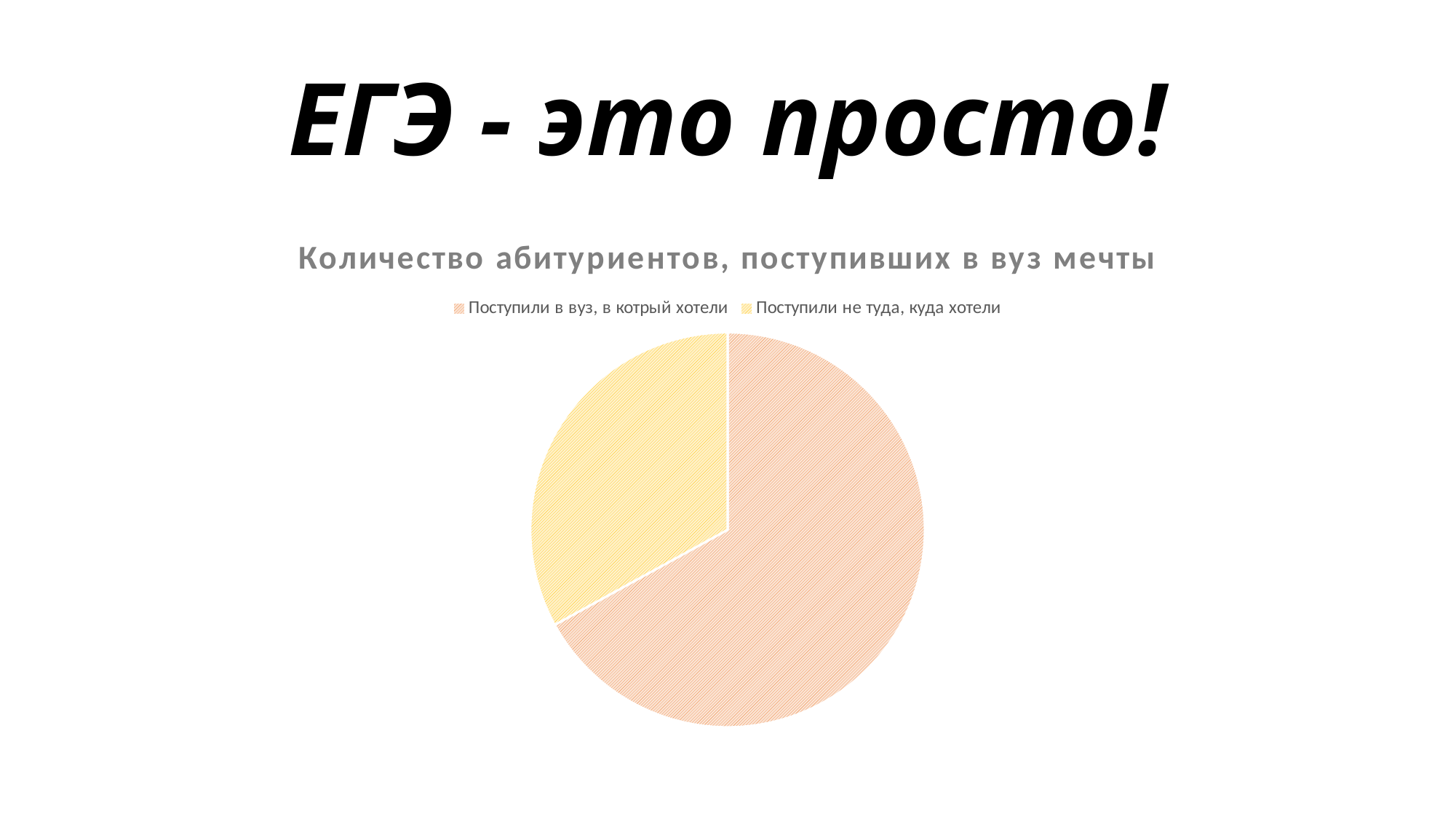
What is the title of the chart? Количество абитуриентов, поступивших в вуз мечты How many entries does the chart legend list? 2 How many slices does the pie chart have? 2 Which legend entry is shown in yellow? Поступили не туда, куда хотели Which category has the smallest slice of the pie? Поступили не туда, куда хотели What kind of chart is shown on the slide? pie chart Which category has the largest slice of the pie? Поступили в вуз, в котрый хотели Which slice is larger: "Поступили в вуз, в котрый хотели" or "Поступили не туда, куда хотели"? Поступили в вуз, в котрый хотели